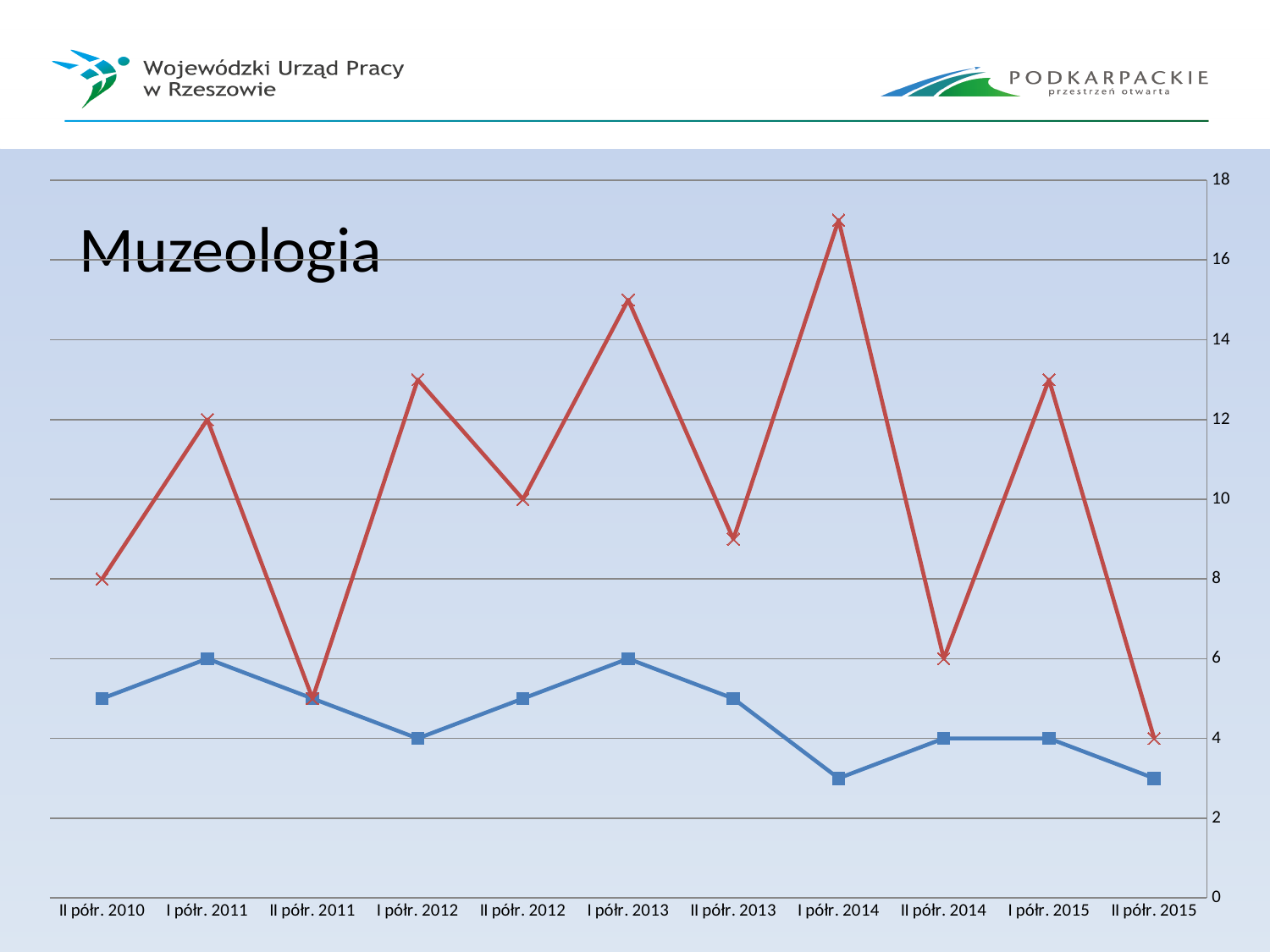
What is the difference between the red line and the blue line for II półr. 2014? 2 What is the value of the blue line for I półr. 2012? 4 Is the value of the red line for I półr. 2014 greater or less than 16? greater What is the value of the red line for II półr. 2015? 4 What is the value of the red line for I półr. 2011? 12 How many categories are shown on the x axis? 11 How many lines (data series) are plotted on the chart? 2 Which line has the larger value for I półr. 2014, the red line or the blue line? the red line In which period does the red line reach its highest value? I półr. 2014 What is the value of the red line for II półr. 2010? 8 What is the title of the chart? Muzeologia What kind of chart is shown on the slide? line chart